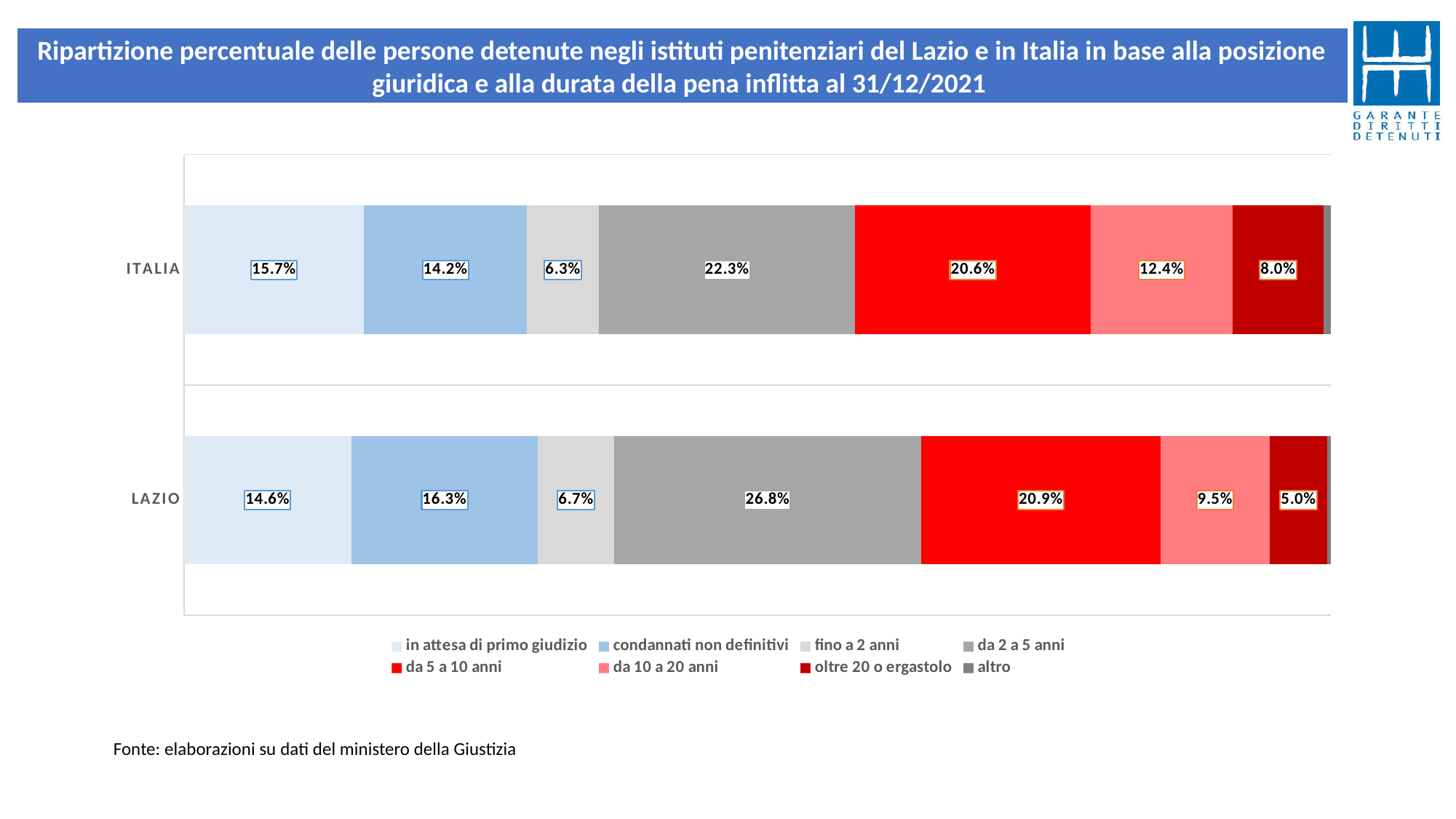
Which has the larger 'condannati non definitivi' share, ITALIA or LAZIO? LAZIO What colour is used for the 'da 5 a 10 anni' series in the legend? Red What type of chart is shown on the slide? Stacked bar chart What is the difference between the 'da 2 a 5 anni' values for LAZIO and ITALIA? 4.5 percentage points How many categories (bars) does the chart show? 2 How many series does the legend list? 8 What is the value of the 'da 5 a 10 anni' segment for LAZIO? 20.9% Which series has the largest labeled segment in the LAZIO bar? da 2 a 5 anni What is the value of the 'in attesa di primo giudizio' segment for ITALIA? 15.7% What is the difference between the 'da 10 a 20 anni' values for ITALIA and LAZIO? 2.9 percentage points What is the value of the 'da 2 a 5 anni' segment for ITALIA? 22.3% What is the value of the 'oltre 20 o ergastolo' segment for LAZIO? 5.0%